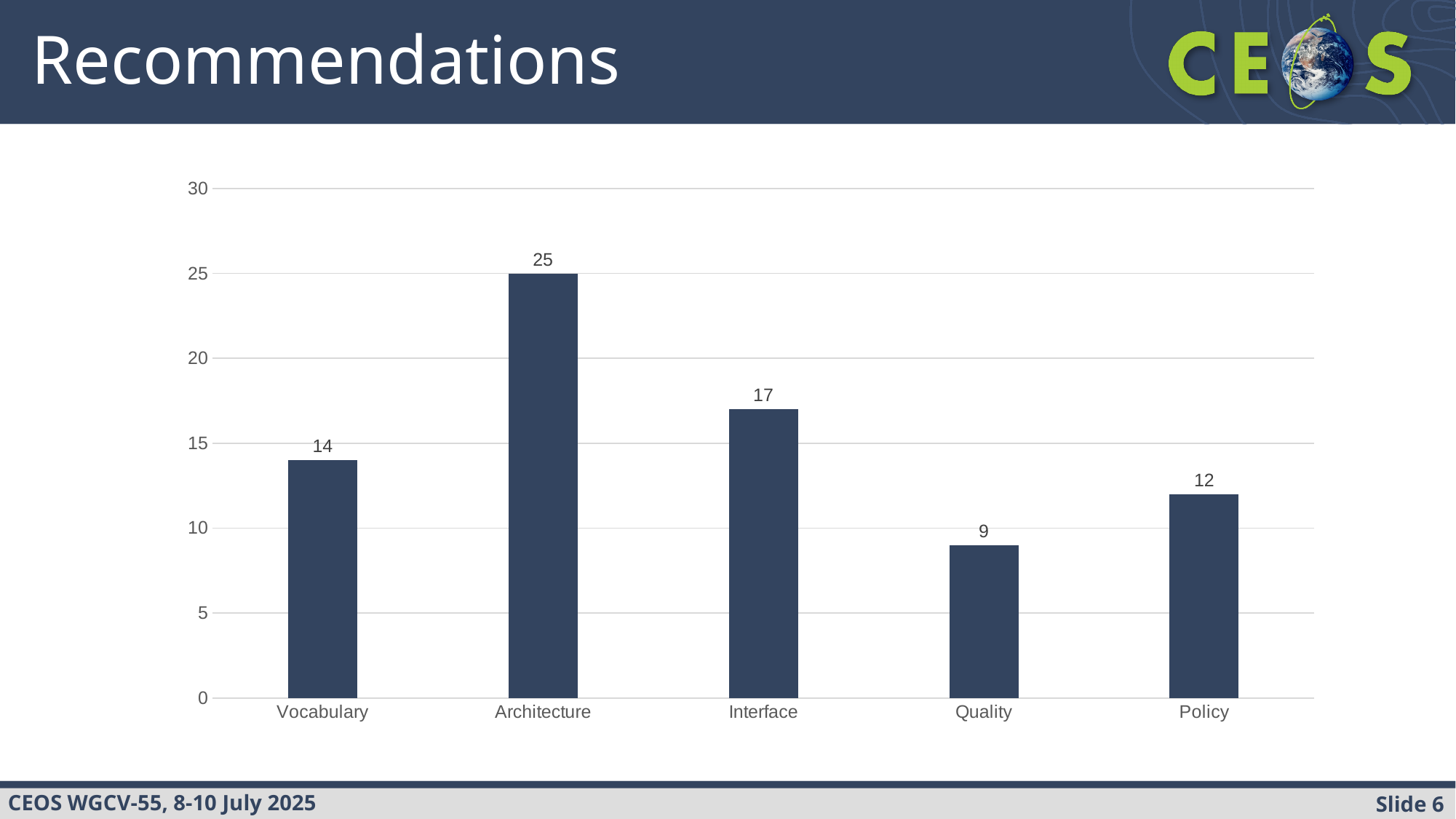
Which category has the lowest value? Quality What is the difference between the values for Architecture and Interface? 8 How many categories are shown on the x axis? 5 What is the value for Quality? 9 Which category has the highest value? Architecture What is the difference between the values for Vocabulary and Policy? 2 What kind of chart is shown on the slide? bar chart What is the value for Policy? 12 What is the title of the slide containing the chart? Recommendations Is the value for Interface greater or less than 15? greater What is the value for Architecture? 25 Which is larger, the value for Vocabulary or the value for Interface? Interface